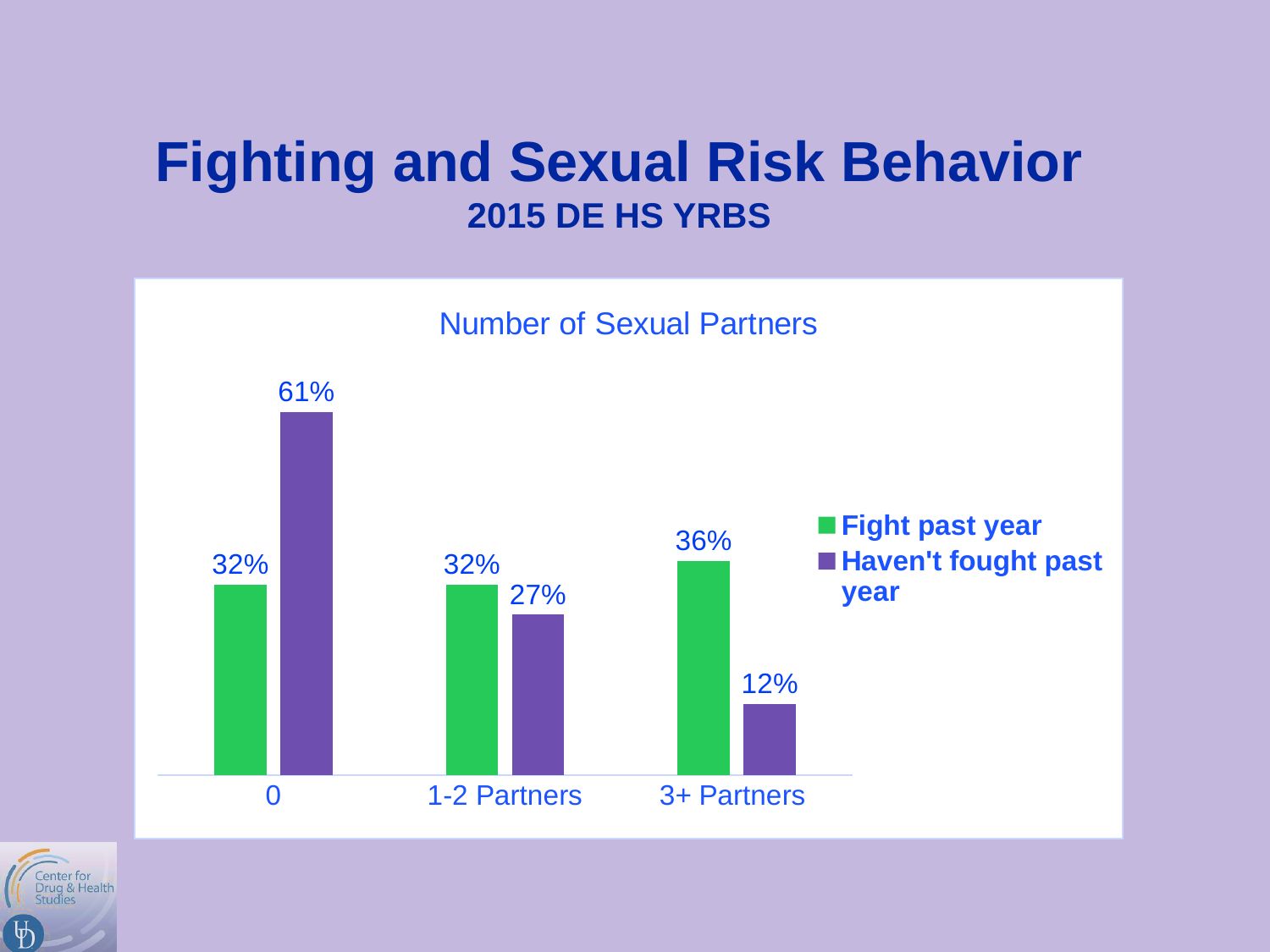
Which category has the highest value for the 'Haven't fought past year' series? 0 What is the difference between the 'Haven't fought past year' and 'Fight past year' values in the 0 partners category? 29% What kind of chart is shown on the slide? Bar chart What percentage of students who haven't fought in the past year reported 0 sexual partners? 61% What percentage of students who fought in the past year reported 3+ sexual partners? 36% What is the title of the chart? Number of Sexual Partners What is the difference between the 'Fight past year' and 'Haven't fought past year' values for 3+ Partners? 24% What is the value for 'Haven't fought past year' in the 1-2 Partners category? 27% How many categories are shown on the x axis? 3 Which category has the lowest value for the 'Haven't fought past year' series? 3+ Partners How many series does the legend list? 2 In the 1-2 Partners category, which series has the larger value? Fight past year